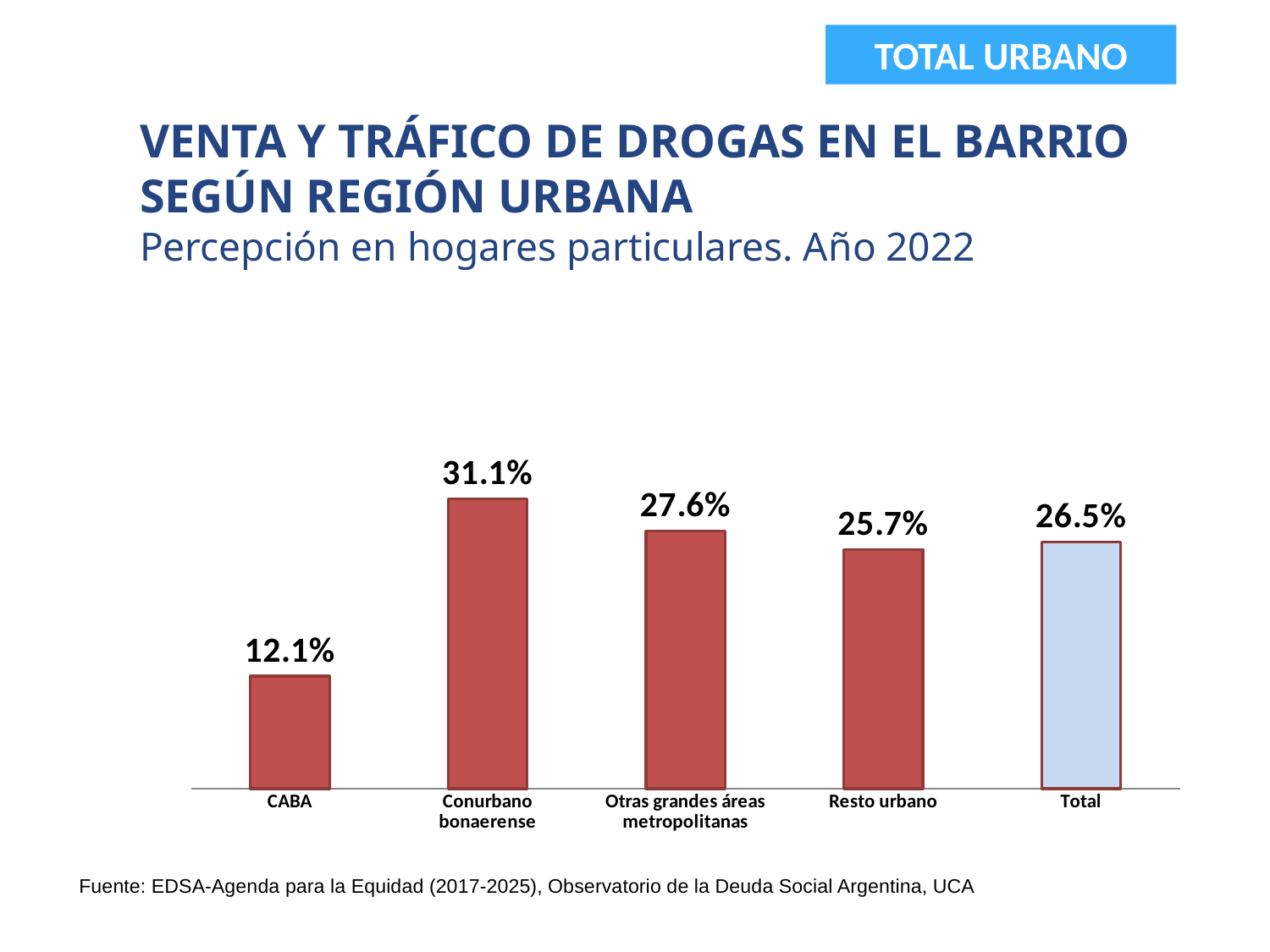
Which category has the lowest value? CABA How many categories are shown on the x axis? 5 What is the difference between the values for Conurbano bonaerense and CABA? 19 percentage points What kind of chart is shown on the slide? Bar chart Which category has the highest value? Conurbano bonaerense Which is larger, the value for Otras grandes áreas metropolitanas or the value for Resto urbano? Otras grandes áreas metropolitanas What is the value for Total? 26.5% What is the value for Resto urbano? 25.7% Which bar is shown in a different (light blue) colour from the others? Total What is the value for CABA? 12.1% What is the value for Otras grandes áreas metropolitanas? 27.6% What is the value for Conurbano bonaerense? 31.1%